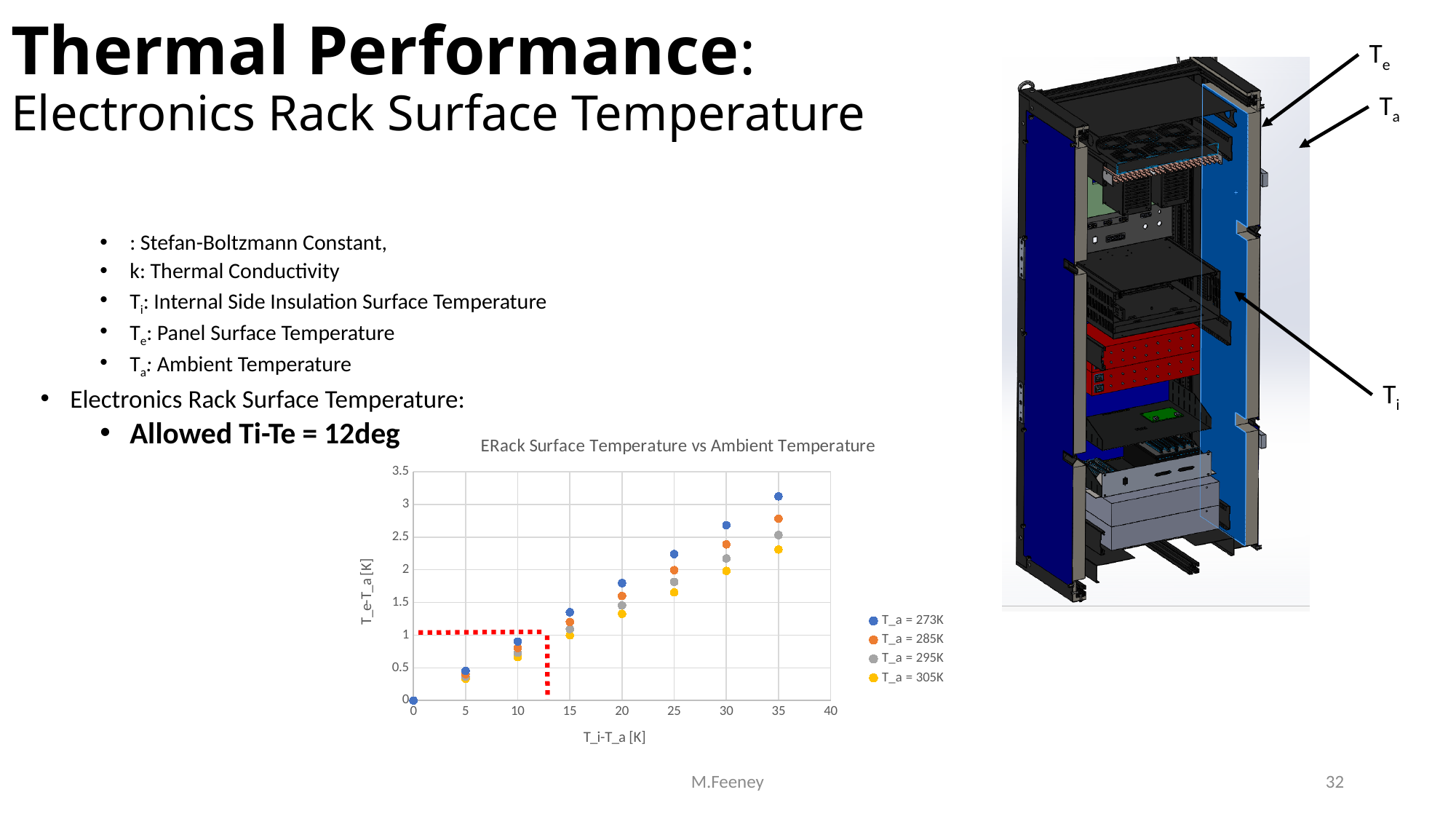
Do the values for the T_a = 305K series rise or fall as T_i-T_a increases? rise Is the value for T_a = 273K at T_i-T_a = 35 greater or less than 3? greater Which series has the highest value at T_i-T_a = 35? T_a = 273K Is the value for T_a = 305K at T_i-T_a = 35 greater or less than 2.5? less Is the value for T_a = 273K at T_i-T_a = 10 greater or less than 1? less At T_i-T_a = 30, which is larger: the value for T_a = 285K or the value for T_a = 305K? T_a = 285K Which series has the lowest value at T_i-T_a = 35? T_a = 305K How many series does the chart legend list? 4 What kind of chart is shown on the slide? scatter chart How many data points are plotted for the T_a = 273K series? 8 What is the label of the chart's x axis? T_i-T_a [K] What is the title of the chart? ERack Surface Temperature vs Ambient Temperature